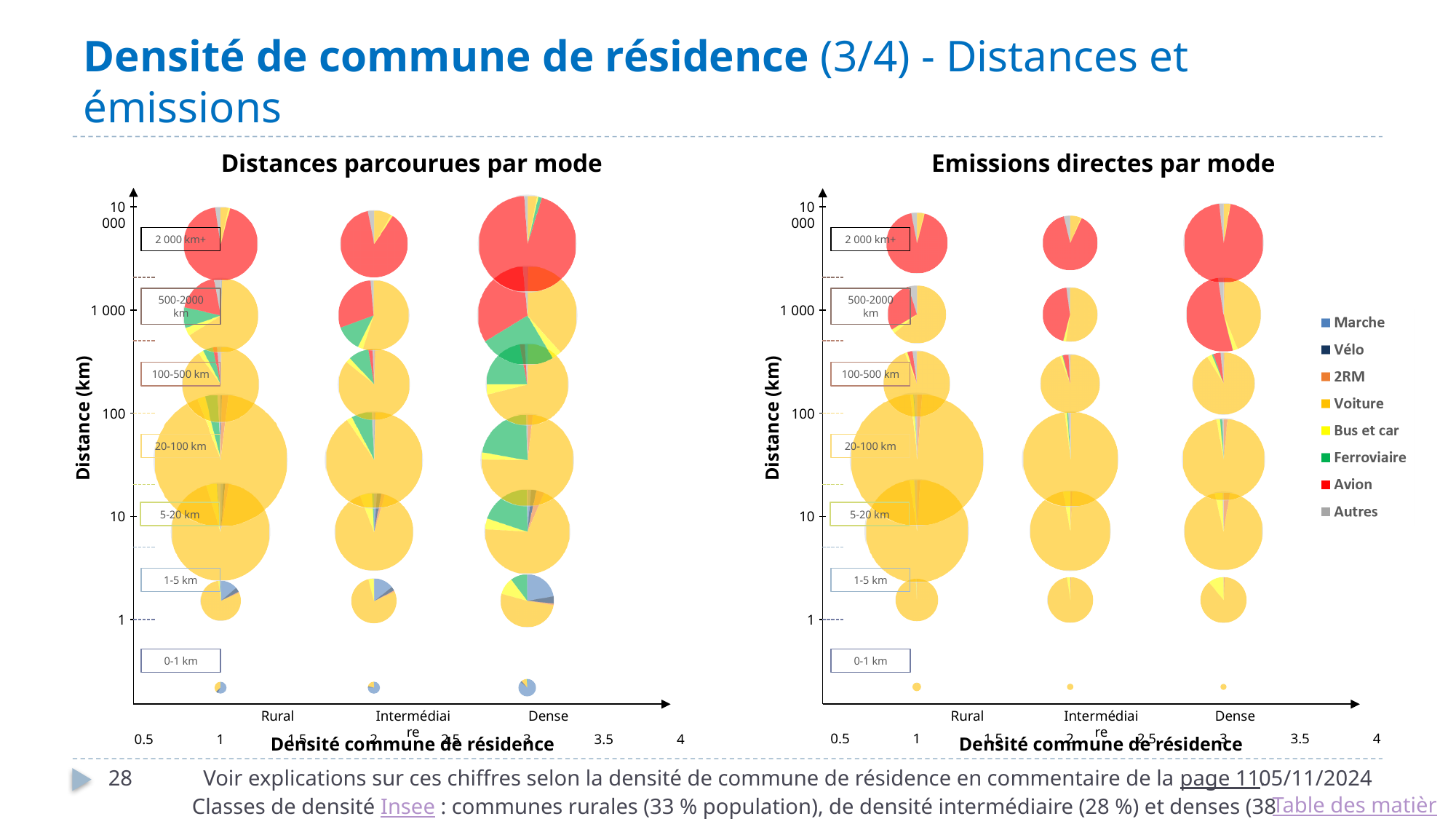
In the 'Distances parcourues par mode' chart, which distance class has the smallest bubble for Dense? 0-1 km How many distance classes are labelled on the 'Distances parcourues par mode' chart? 7 What kind of chart is the 'Distances parcourues par mode' chart? bubble chart of pie charts How many density categories are shown on the x axis of the 'Emissions directes par mode' chart? 3 In the 'Distances parcourues par mode' chart, which density category has the larger bubble for the 2 000 km+ class, Intermédiaire or Dense? Dense What is the title of the right-hand chart? Emissions directes par mode In the 'Emissions directes par mode' chart, which distance class has the largest bubble for Rural? 20-100 km In the 'Emissions directes par mode' chart, which density category has the larger bubble for the 500-2000 km class, Rural or Dense? Dense How many series does the legend on the slide list? 8 In the 'Distances parcourues par mode' chart, which mode dominates the 2 000 km+ bubbles? Avion What is the y-axis label of the 'Distances parcourues par mode' chart? Distance (km)